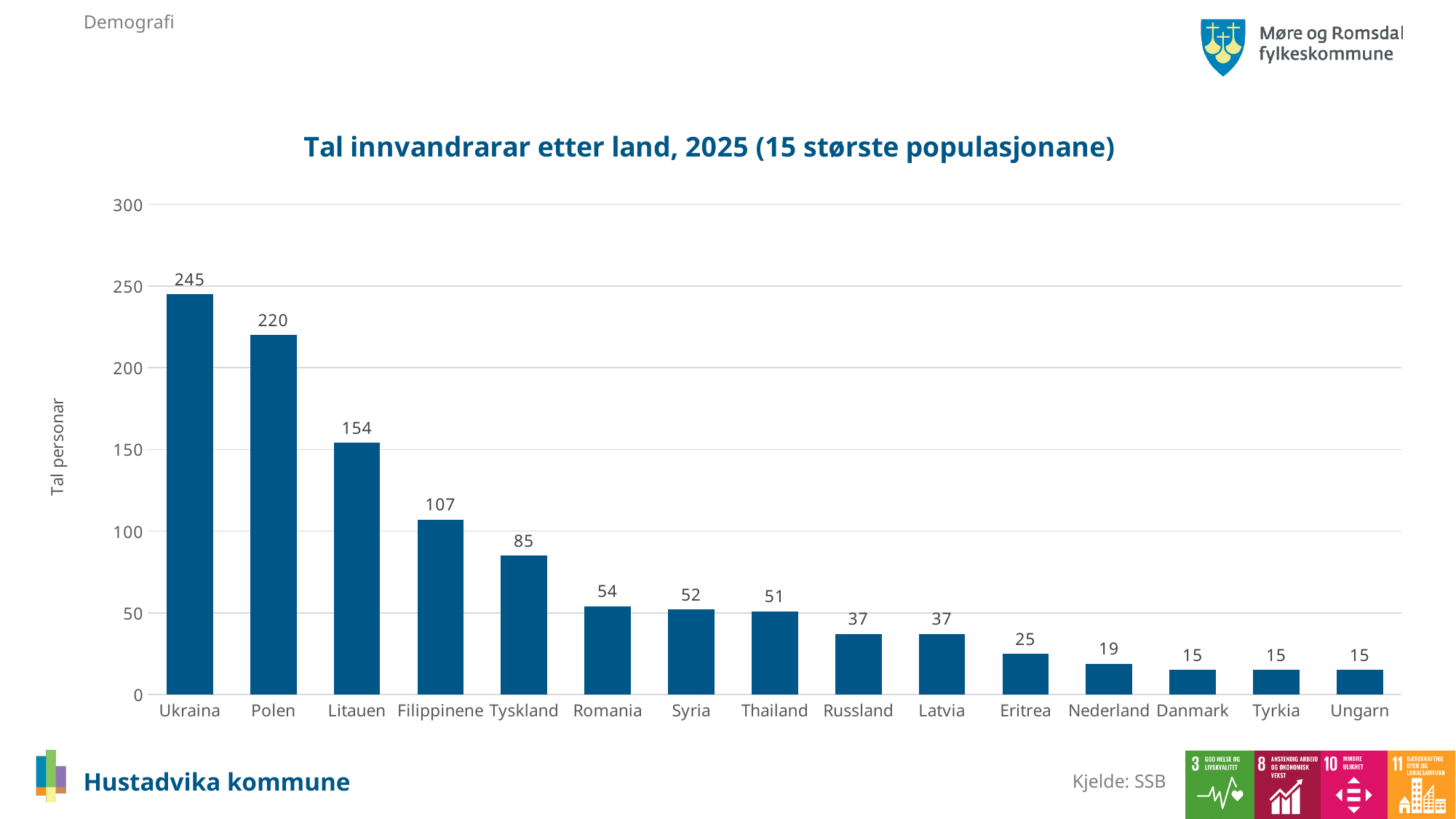
Which country has the highest value? Ukraina What is the title of the chart? Tal innvandrarar etter land, 2025 (15 største populasjonane) What is the difference between the values for Ukraina and Polen? 25 What is the value for Eritrea? 25 What is the value for Filippinene? 107 Which is larger, the value for Romania or the value for Thailand? Romania How many countries are shown on the chart? 15 What kind of chart is this? bar chart What is the difference between the values for Litauen and Tyskland? 69 What is the value for Ukraina? 245 Do the values rise or fall from left to right along the x axis? fall Is the value for Litauen greater or less than 150? greater